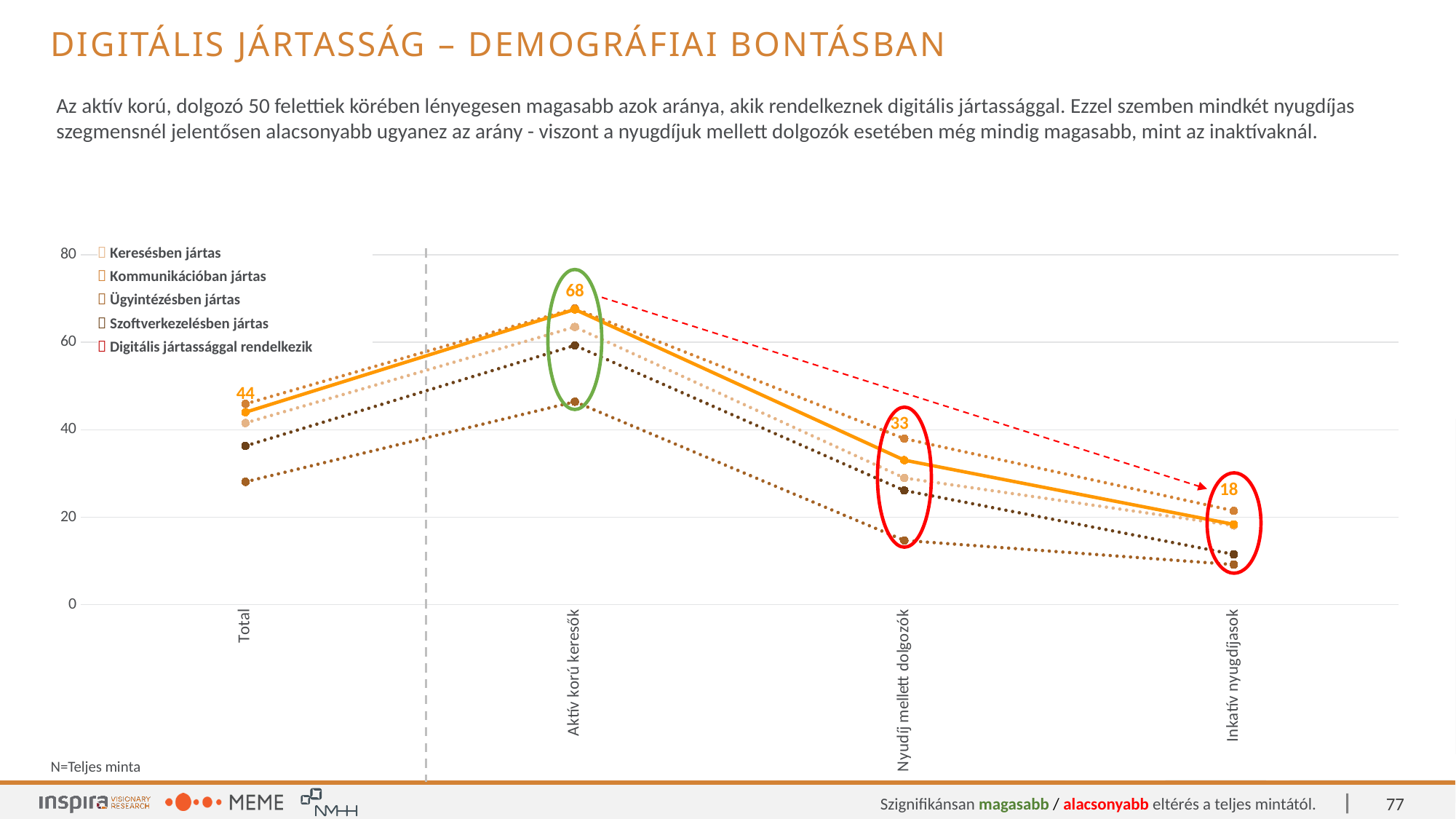
How many categories are shown on the x axis of the chart? 4 What kind of chart is shown on the slide? Line chart What is the value of the Digitális jártassággal rendelkezik line for Aktív korú keresők? 68 Which category has the highest value on the Digitális jártassággal rendelkezik line? Aktív korú keresők What is the difference between the Digitális jártassággal rendelkezik values for Aktív korú keresők and Nyudíj mellett dolgozók? 35 How many series does the legend list? 5 What is the value of the Digitális jártassággal rendelkezik line for Total? 44 What is the difference between the Digitális jártassággal rendelkezik values for Total and Inkatív nyugdíjasok? 26 What is the value of the Digitális jártassággal rendelkezik line for Nyudíj mellett dolgozók? 33 What is the value of the Digitális jártassággal rendelkezik line for Inkatív nyugdíjasok? 18 On the Digitális jártassággal rendelkezik line, which is larger: Total or Nyudíj mellett dolgozók? Total Which category has the lowest value on the Digitális jártassággal rendelkezik line? Inkatív nyugdíjasok